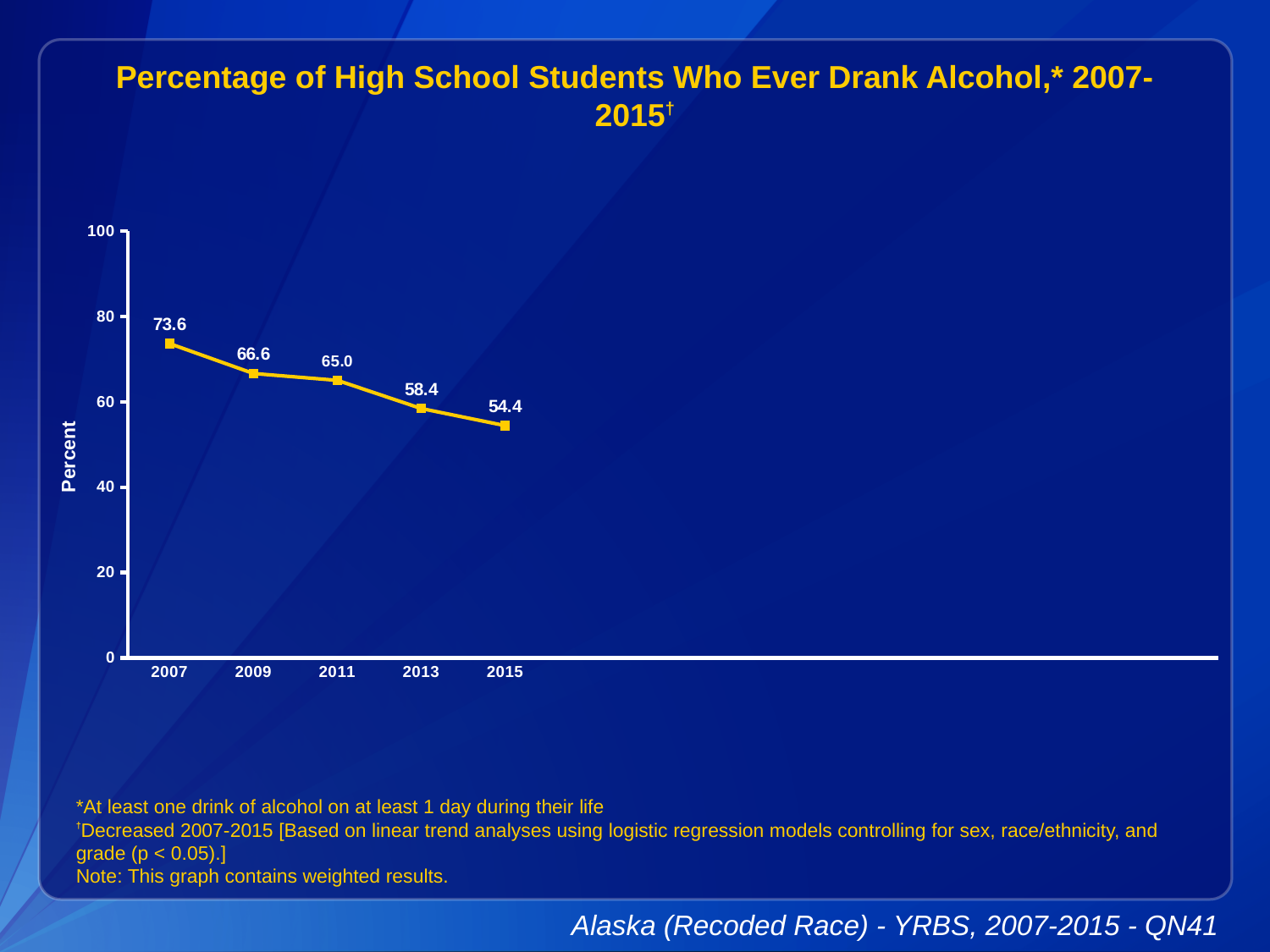
Is the value for 2013 greater or less than 60? less Which year has the lowest percentage? 2015 Do the values rise or fall from 2007 to 2015? fall What kind of chart is shown? line chart Which year has the highest percentage? 2007 What is the difference between the 2009 and 2011 values? 1.6 How many years are plotted on the chart? 5 What percentage of high school students had ever drunk alcohol in 2007? 73.6 What is the value plotted for 2011? 65.0 What is the value plotted for 2015? 54.4 Which year has a larger value, 2013 or 2009? 2009 By how many percentage points did the value fall from 2007 to 2015? 19.2